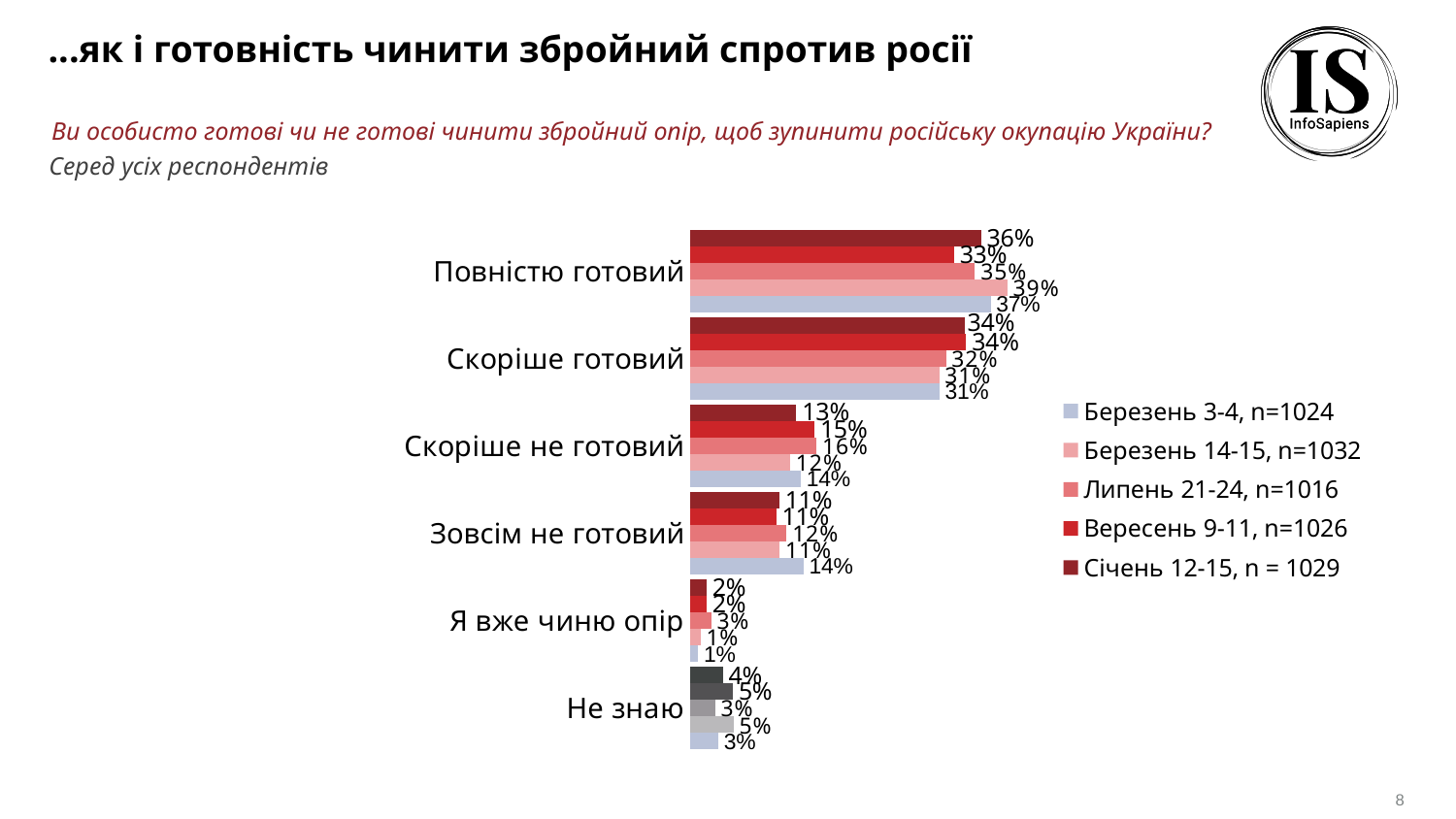
What kind of chart is shown on the slide? Bar chart What is the value for "Зовсім не готовий" in the "Березень 3-4, n=1024" series? 14% What is the value for "Повністю готовий" in the "Січень 12-15, n = 1029" series? 36% Which category has the lowest value in the "Березень 3-4, n=1024" series? Я вже чиню опір How many series does the legend list? 5 What is the value for "Не знаю" in the "Січень 12-15, n = 1029" series? 4% For "Скоріше не готовий", which is larger: the "Липень 21-24, n=1016" value or the "Березень 14-15, n=1032" value? Липень 21-24, n=1016 For "Повністю готовий", what is the difference between the "Березень 14-15, n=1032" value and the "Вересень 9-11, n=1026" value? 6 percentage points How many answer categories are plotted on the chart? 6 Which survey wave has the highest value for "Повністю готовий"? Березень 14-15, n=1032 What is the value for "Повністю готовий" in the "Березень 3-4, n=1024" series? 37% What sample size does the legend give for the "Січень 12-15" series? n = 1029